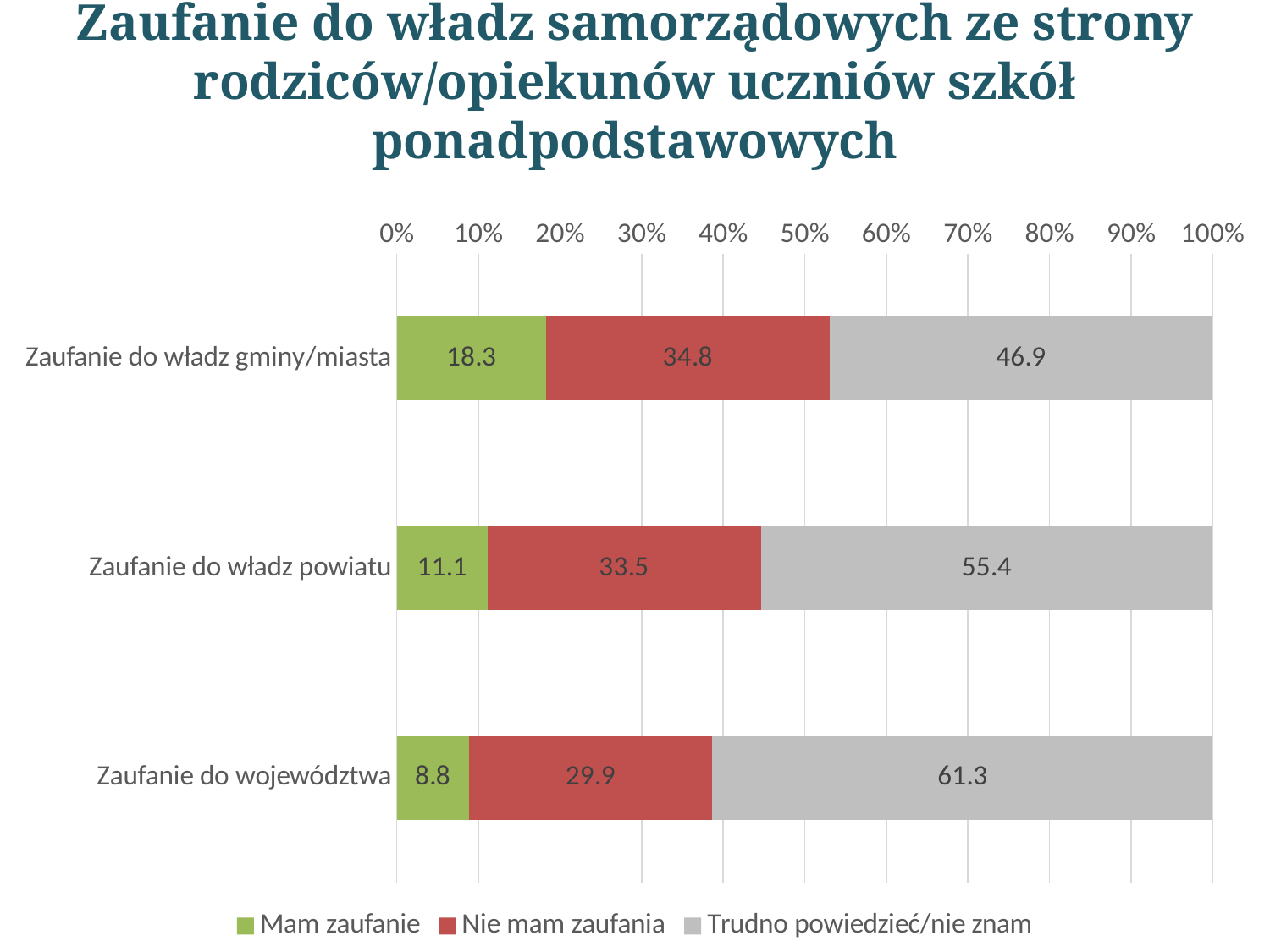
What is the difference between the "Mam zaufanie" values for "Zaufanie do władz gminy/miasta" and "Zaufanie do władz powiatu"? 7.2 What is the value of "Mam zaufanie" for "Zaufanie do władz gminy/miasta"? 18.3 Is the "Trudno powiedzieć/nie znam" value for "Zaufanie do władz powiatu" greater or less than 50%? greater Which is larger: "Nie mam zaufania" for "Zaufanie do władz gminy/miasta" or for "Zaufanie do województwa"? Zaufanie do władz gminy/miasta Which category has the highest value for "Trudno powiedzieć/nie znam"? Zaufanie do województwa Which category has the lowest value for "Mam zaufanie"? Zaufanie do województwa How many series does the legend list? 3 What is the value of "Trudno powiedzieć/nie znam" for "Zaufanie do województwa"? 61.3 How many categories are shown on the chart? 3 What is the value of "Nie mam zaufania" for "Zaufanie do władz powiatu"? 33.5 What kind of chart is shown on the slide? Stacked bar chart Which colour represents "Nie mam zaufania" in the chart? Red